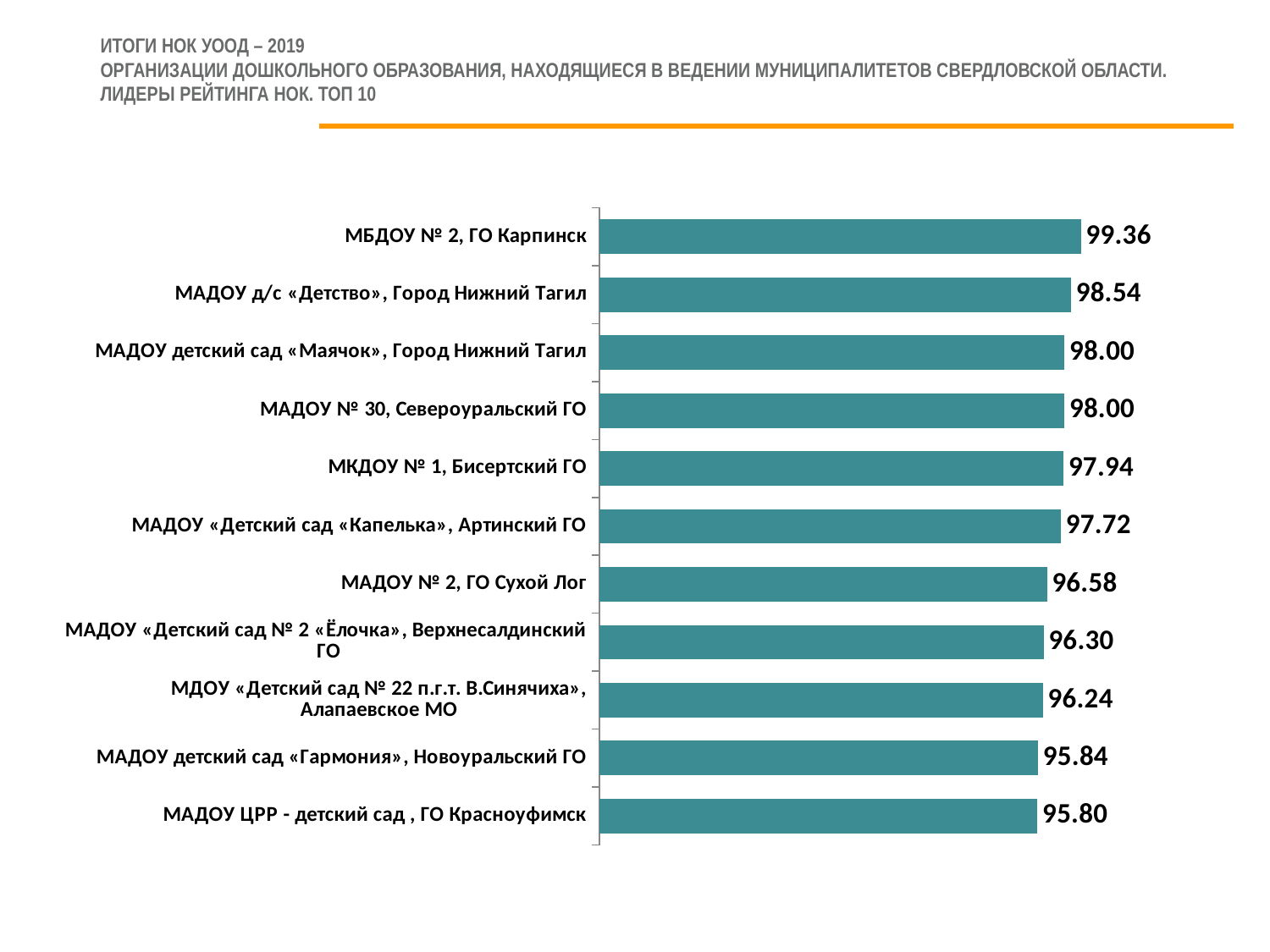
What is the value for МАДОУ № 2, ГО Сухой Лог? 96.58 What is the value for МАДОУ ЦРР - детский сад, ГО Красноуфимск? 95.80 What is the value for МАДОУ д/с «Детство», Город Нижний Тагил? 98.54 What is the difference between the values for МБДОУ № 2, ГО Карпинск and МАДОУ ЦРР - детский сад, ГО Красноуфимск? 3.56 What is the value for МБДОУ № 2, ГО Карпинск? 99.36 Which has a larger value: МАДОУ № 2, ГО Сухой Лог or МАДОУ детский сад «Гармония», Новоуральский ГО? МАДОУ № 2, ГО Сухой Лог Which two organisations share the value 98.00? МАДОУ детский сад «Маячок», Город Нижний Тагил and МАДОУ № 30, Североуральский ГО How many organisations are shown in the chart? 11 What kind of chart is shown on the slide? Bar chart What is the difference between the values for МКДОУ № 1, Бисертский ГО and МАДОУ «Детский сад «Капелька», Артинский ГО? 0.22 Which organisation has the highest value? МБДОУ № 2, ГО Карпинск Which organisation has the lowest value? МАДОУ ЦРР - детский сад, ГО Красноуфимск